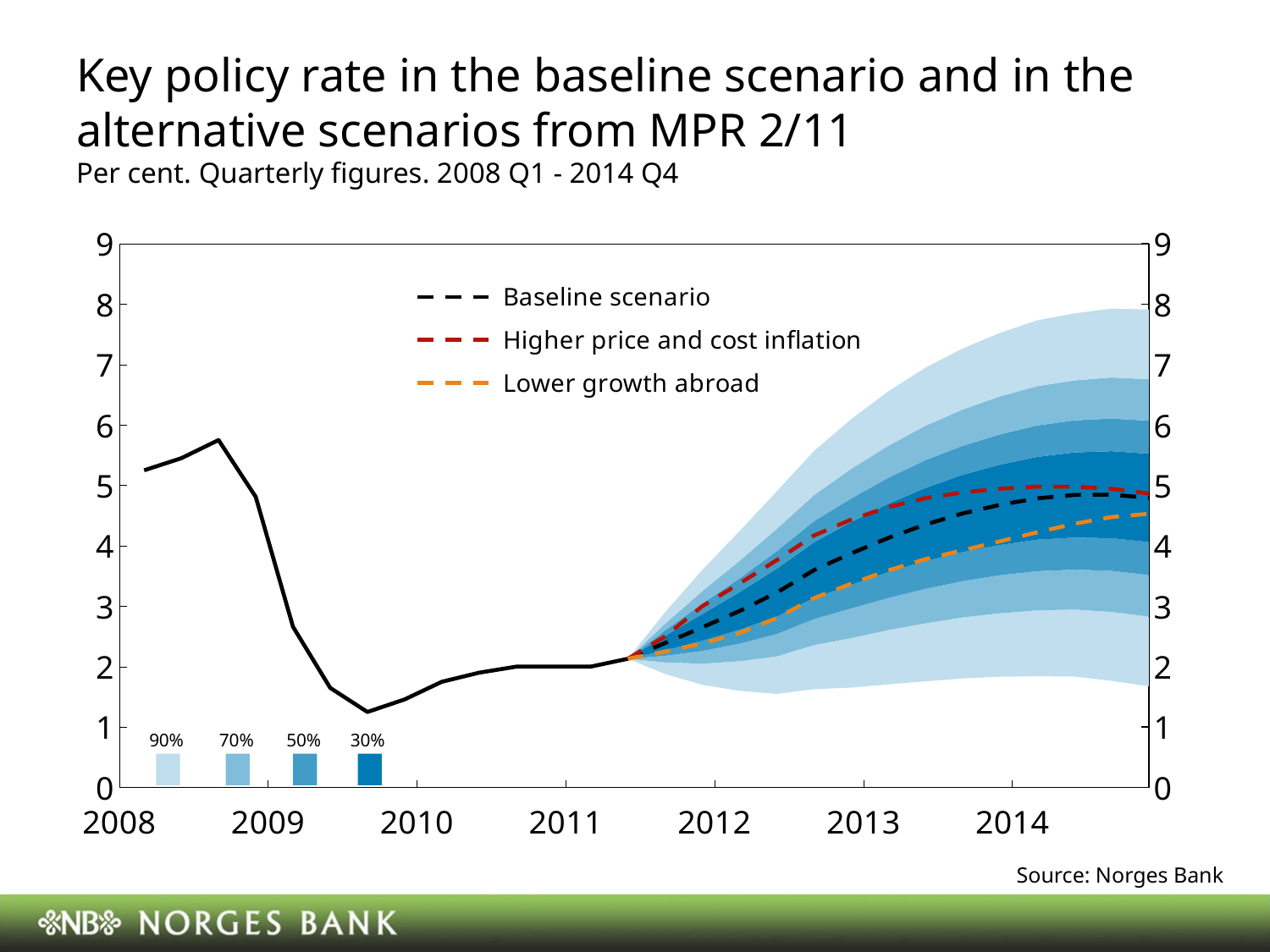
Is the Lower growth abroad value at the start of 2012 greater or less than 3? less Is the lowest point of the solid key policy rate line, reached in 2009, greater or less than 2? less What colour is the Lower growth abroad line? orange At the start of 2013, which scenario shows the lowest key policy rate? Lower growth abroad Does the solid key policy rate line rise or fall from 2008 to 2009? fall At the start of 2013, which scenario shows the highest key policy rate? Higher price and cost inflation Is the key policy rate at the start of 2008 greater or less than 4? greater Does the Baseline scenario line rise or fall from mid-2011 to 2014? rise What kind of chart is shown on the slide? line chart How many scenarios does the legend list? 3 At the end of 2014, which is higher: Higher price and cost inflation or Lower growth abroad? Higher price and cost inflation